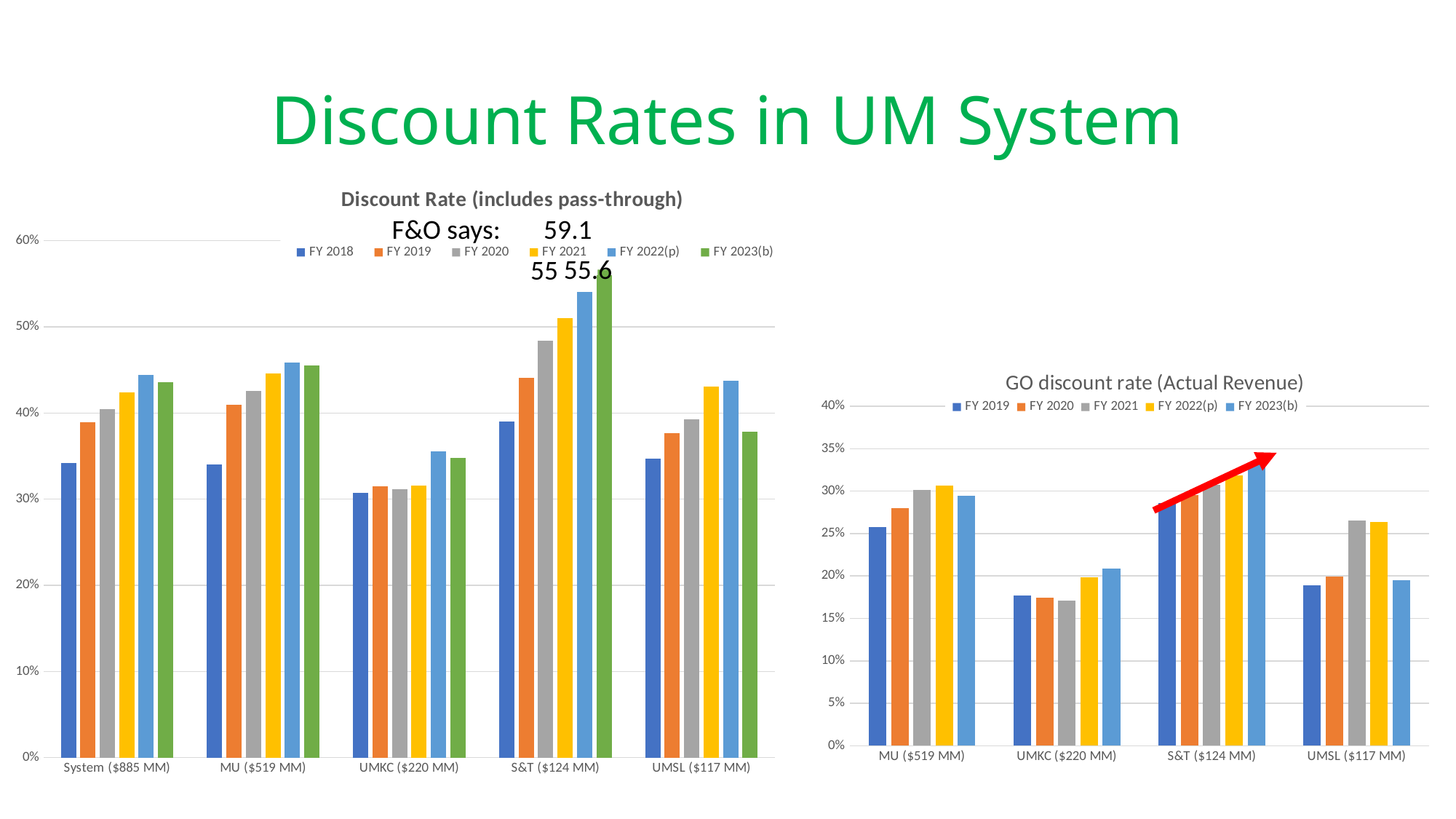
How many series does the legend of the 'GO discount rate (Actual Revenue)' chart list? 5 In the 'Discount Rate (includes pass-through)' chart, which is larger: the FY 2023(b) value for S&T ($124 MM) or for MU ($519 MM)? S&T ($124 MM) In the 'Discount Rate (includes pass-through)' chart, is the FY 2023(b) value for UMSL ($117 MM) greater or less than 40%? less How many series does the legend of the 'Discount Rate (includes pass-through)' chart list? 6 In the 'Discount Rate (includes pass-through)' chart, is the FY 2021 value for S&T ($124 MM) greater or less than 50%? greater How many categories are shown on the x axis of the 'GO discount rate (Actual Revenue)' chart? 4 In the 'GO discount rate (Actual Revenue)' chart, is the FY 2021 value for UMKC ($220 MM) greater or less than 20%? less How many categories are shown on the x axis of the 'Discount Rate (includes pass-through)' chart? 5 In the 'GO discount rate (Actual Revenue)' chart, do the values for S&T ($124 MM) rise or fall from FY 2019 to FY 2023(b)? rise In the 'GO discount rate (Actual Revenue)' chart, which category has the lowest bars overall? UMKC ($220 MM) What type of chart is the 'Discount Rate (includes pass-through)' chart on the left? bar chart In the 'Discount Rate (includes pass-through)' chart, which category has the tallest bar overall? S&T ($124 MM)